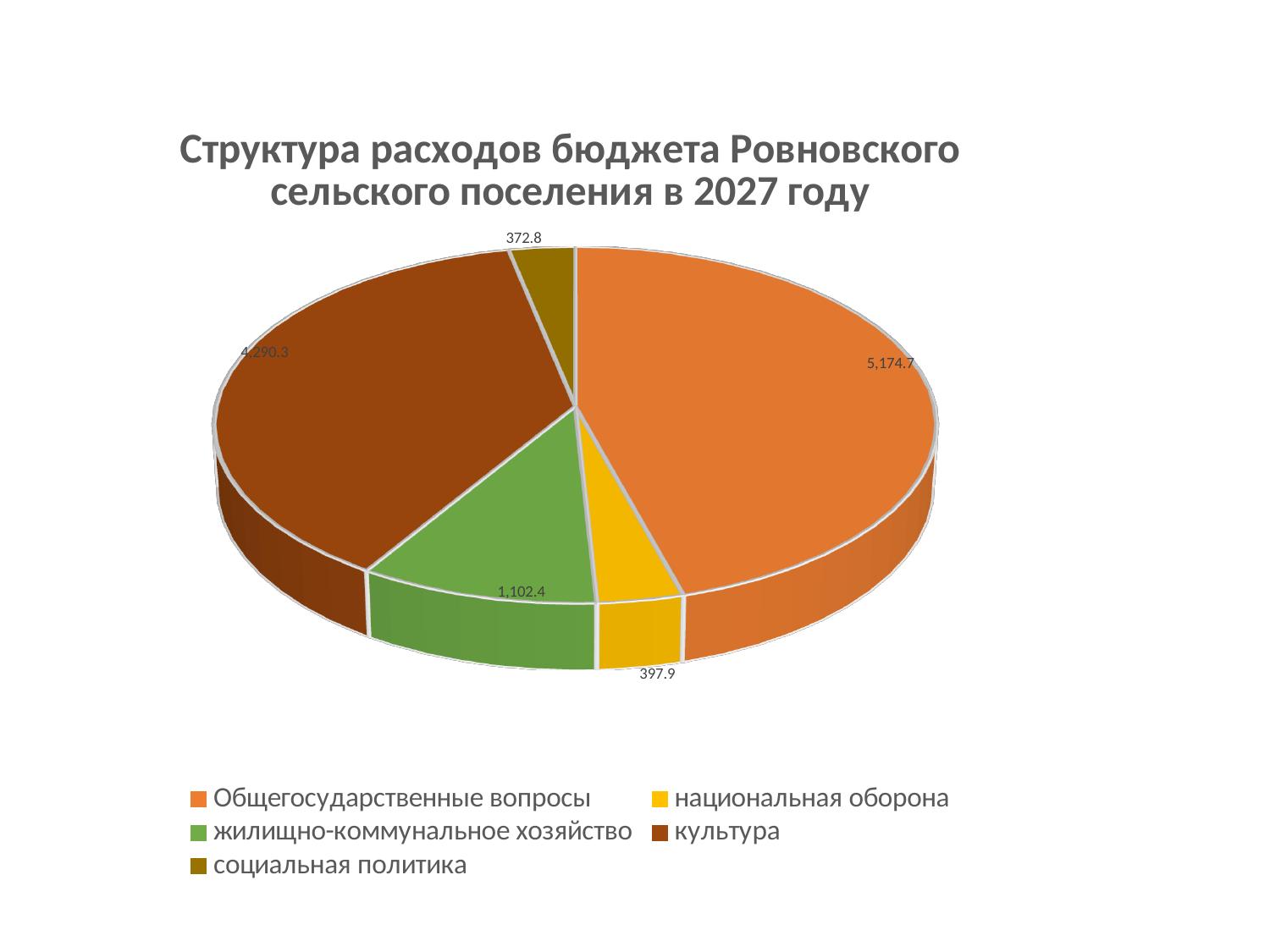
What is the title of the chart? Структура расходов бюджета Ровновского сельского поселения в 2027 году What is the value for социальная политика? 372.8 Which is larger, the value for жилищно-коммунальное хозяйство or the value for национальная оборона? жилищно-коммунальное хозяйство Which category has the smallest slice? социальная политика What is the value for национальная оборона? 397.9 Which category has the largest slice? Общегосударственные вопросы How many slices does the pie chart have? 5 What is the difference between the values for Общегосударственные вопросы and культура? 884.4 What type of chart is shown on the slide? Pie chart What is the value for Общегосударственные вопросы? 5,174.7 What is the value for жилищно-коммунальное хозяйство? 1,102.4 What is the value for культура? 4,290.3